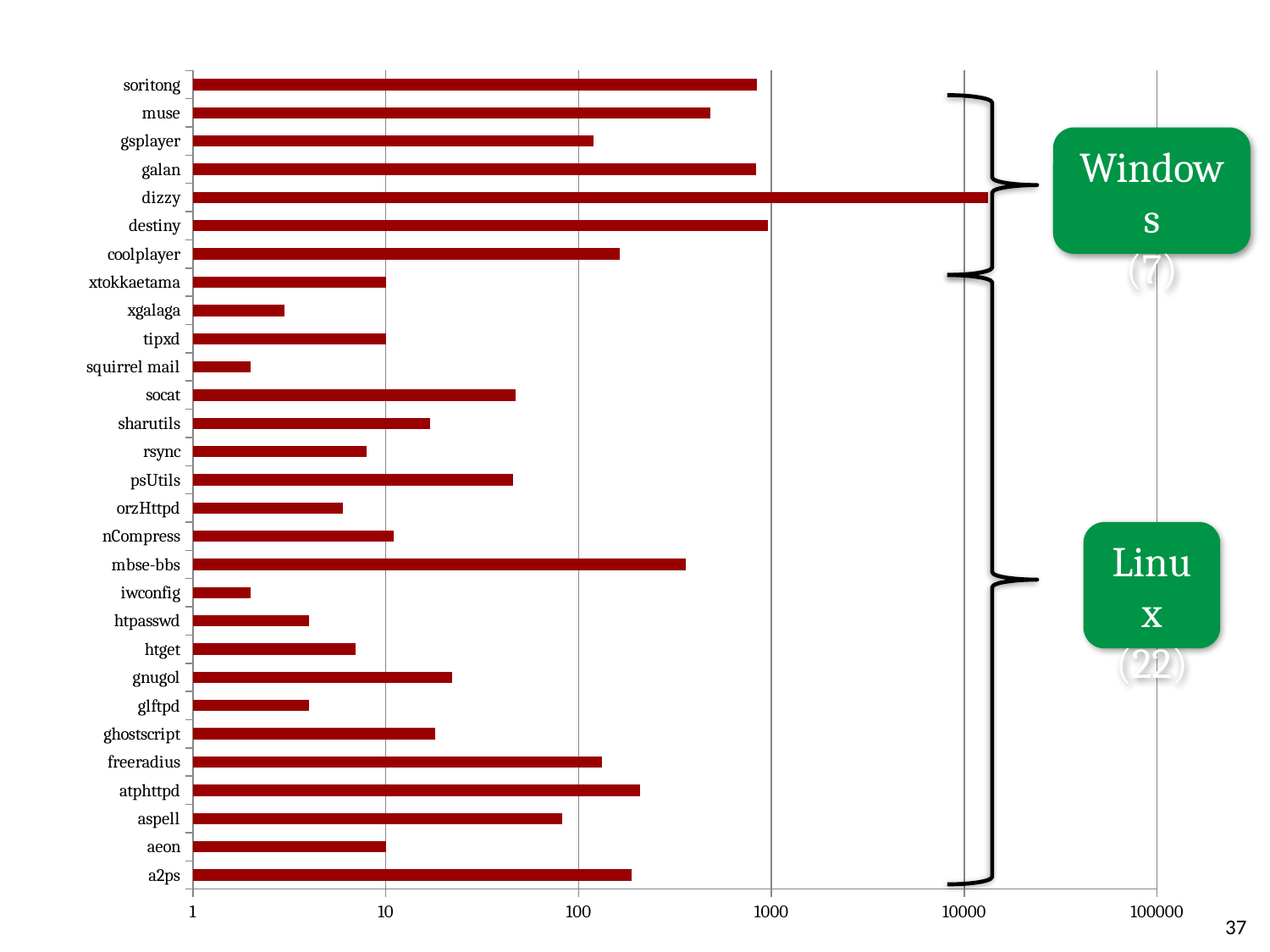
Is the value for dizzy greater or less than 10000? greater Is the value for socat greater or less than 100? less Is the value for mbse-bbs greater or less than 100? greater How many categories (programs) are plotted on the chart? 29 Which has the larger value, mbse-bbs or a2ps? mbse-bbs What is the largest tick value shown on the horizontal axis? 100000 Which program has the highest value on the chart? dizzy What kind of chart is shown on the slide? bar chart Which has the larger value, dizzy or destiny? dizzy According to the bracket labels, how many programs are in the Linux group? 22